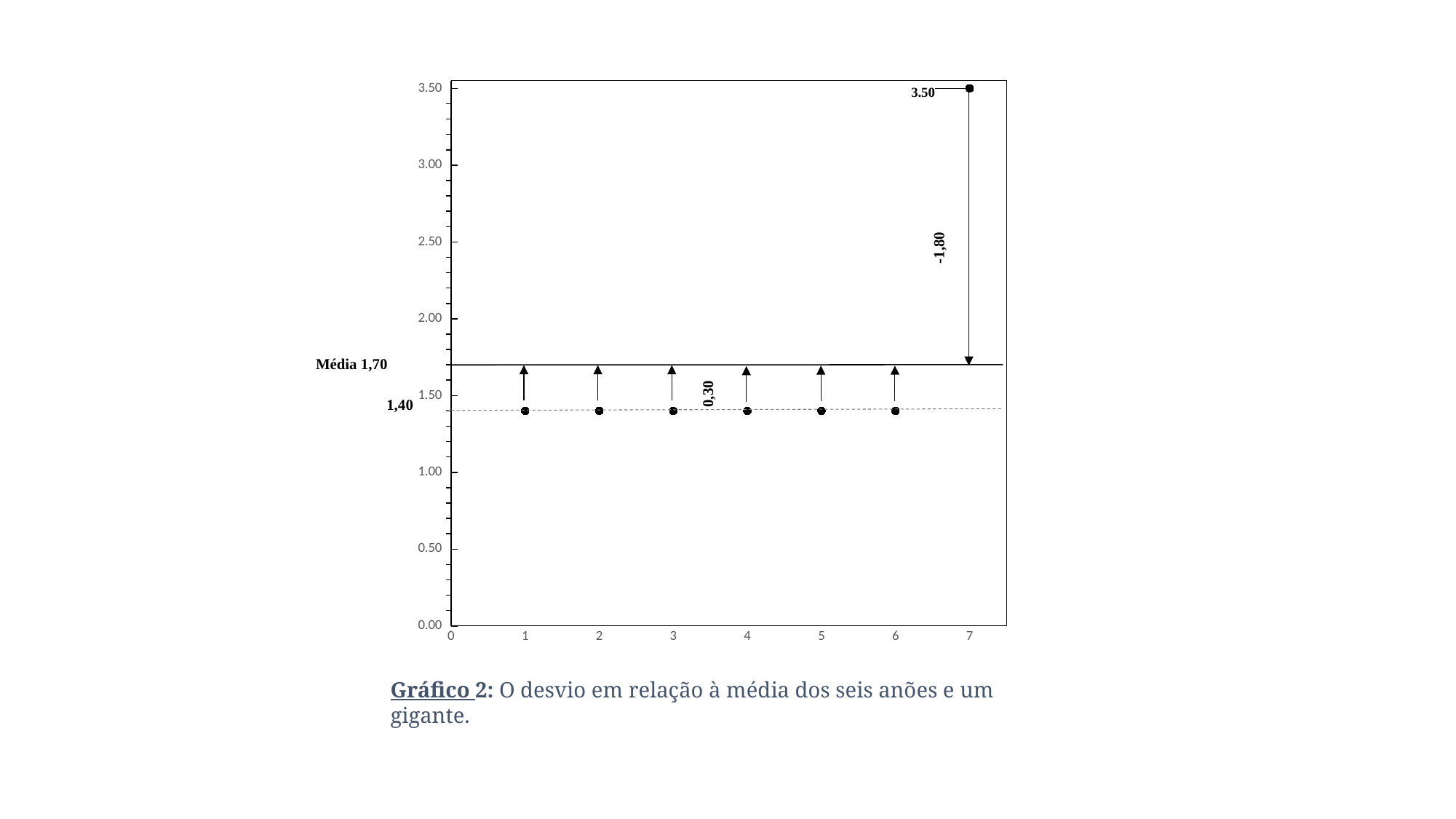
What is the difference between the value at x = 7 (3.50) and the value at x = 6 (1,40)? 2,10 At which x value is the highest plotted point? 7 Which is larger, the value at x = 7 or the value at x = 1? x = 7 What is the caption of the chart shown on the slide? Gráfico 2: O desvio em relação à média dos seis anões e um gigante. What deviation value is labelled next to the upward arrows between the points at 1,40 and the mean line? 0,30 How many data points are plotted on the chart? 7 What is the value of the mean (Média) line shown on the chart? 1,70 Is the value plotted at x = 7 greater or less than 3.00? greater What deviation value is labelled on the vertical arrow between the point at x = 7 and the mean line? -1,80 Is the value plotted at x = 3 greater or less than 1.50? less What value is shown for the dashed line on which points 1 through 6 lie? 1,40 What is the value plotted at x = 7? 3.50